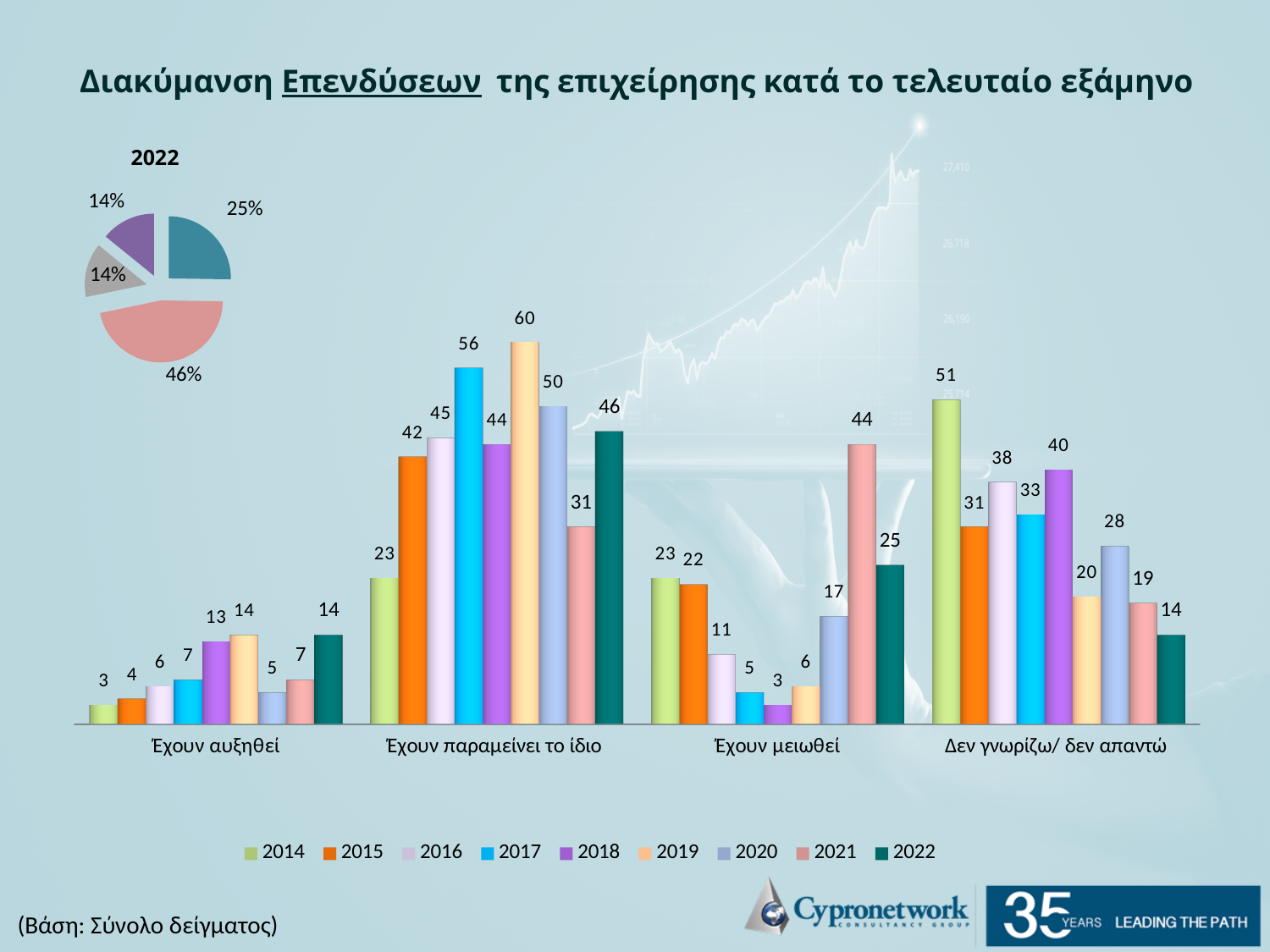
In the bar chart, which year has the highest value in the category 'Έχουν παραμείνει το ίδιο'? 2019 In the bar chart, which is larger in the category 'Δεν γνωρίζω/ δεν απαντώ': the value for 2016 or the value for 2018? 2018 In the bar chart, what is the value for 2022 in the category 'Έχουν παραμείνει το ίδιο'? 46 In the pie chart titled '2022', what is the share of the largest slice? 46% In the bar chart, which year has the lowest value in the category 'Έχουν αυξηθεί'? 2014 In the bar chart, what is the difference between the 2019 and 2021 values in the category 'Έχουν παραμείνει το ίδιο'? 29 How many series does the legend of the bar chart list? 9 In the bar chart, what is the value for 2014 in the category 'Δεν γνωρίζω/ δεν απαντώ'? 51 In the bar chart, what is the value for 2021 in the category 'Έχουν μειωθεί'? 44 What kind of chart is the large chart in the centre of the slide? bar chart How many categories are shown on the x axis of the bar chart? 4 What is the title shown above the pie chart? 2022